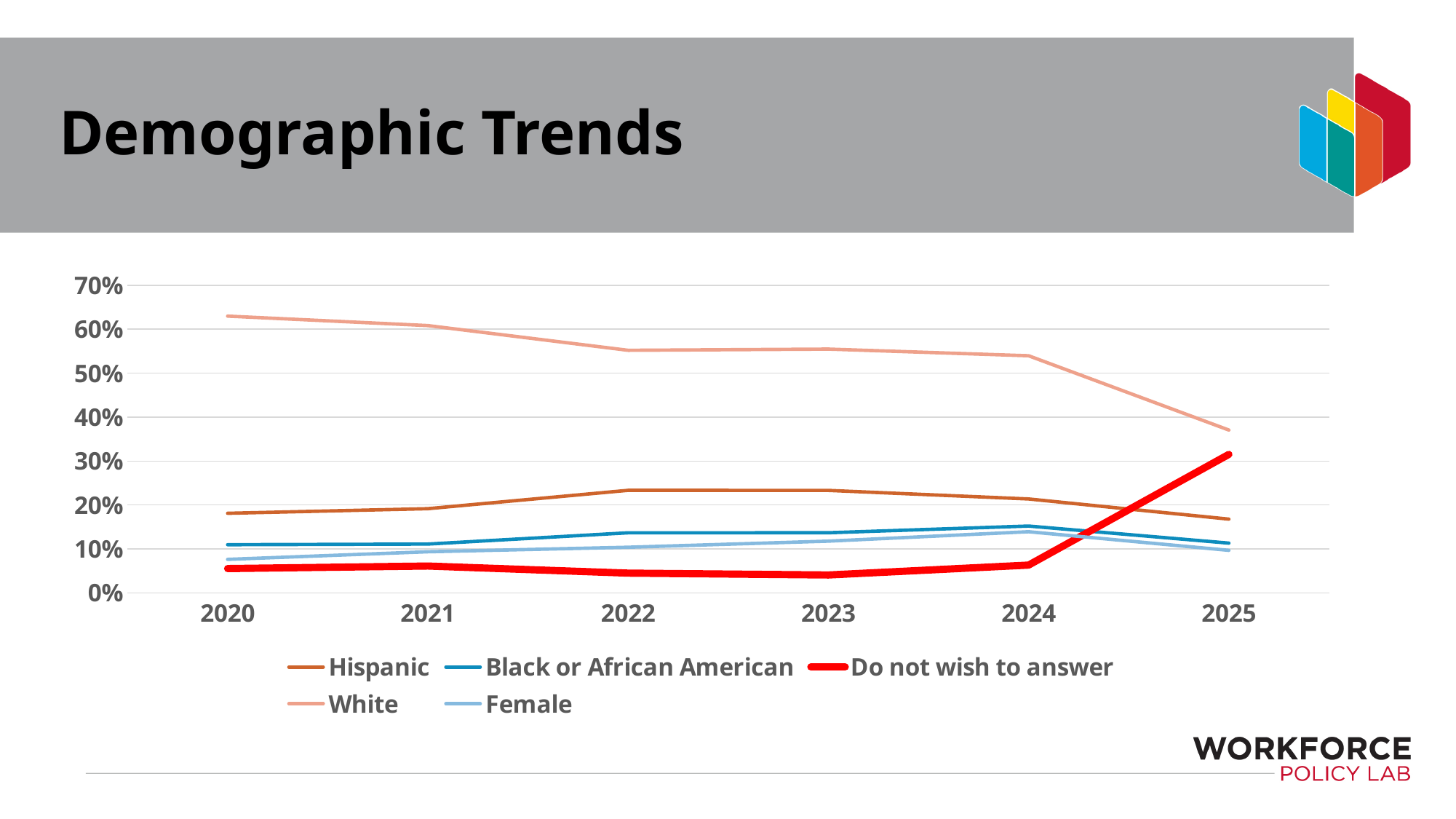
Is the value for Do not wish to answer in 2025 greater or less than 20%? greater Is the value for White in 2025 greater or less than 40%? less Does the White series rise or fall from 2020 to 2025? fall How many series does the legend list? 5 What kind of chart is shown on the slide? line chart Which series has the lowest value in 2023? Do not wish to answer Is the value for Hispanic in 2022 greater or less than 20%? greater What is the title of the chart? Demographic Trends Does the Do not wish to answer series rise or fall from 2024 to 2025? rise Which series has the highest value in 2020? White How many years are shown along the x axis? 6